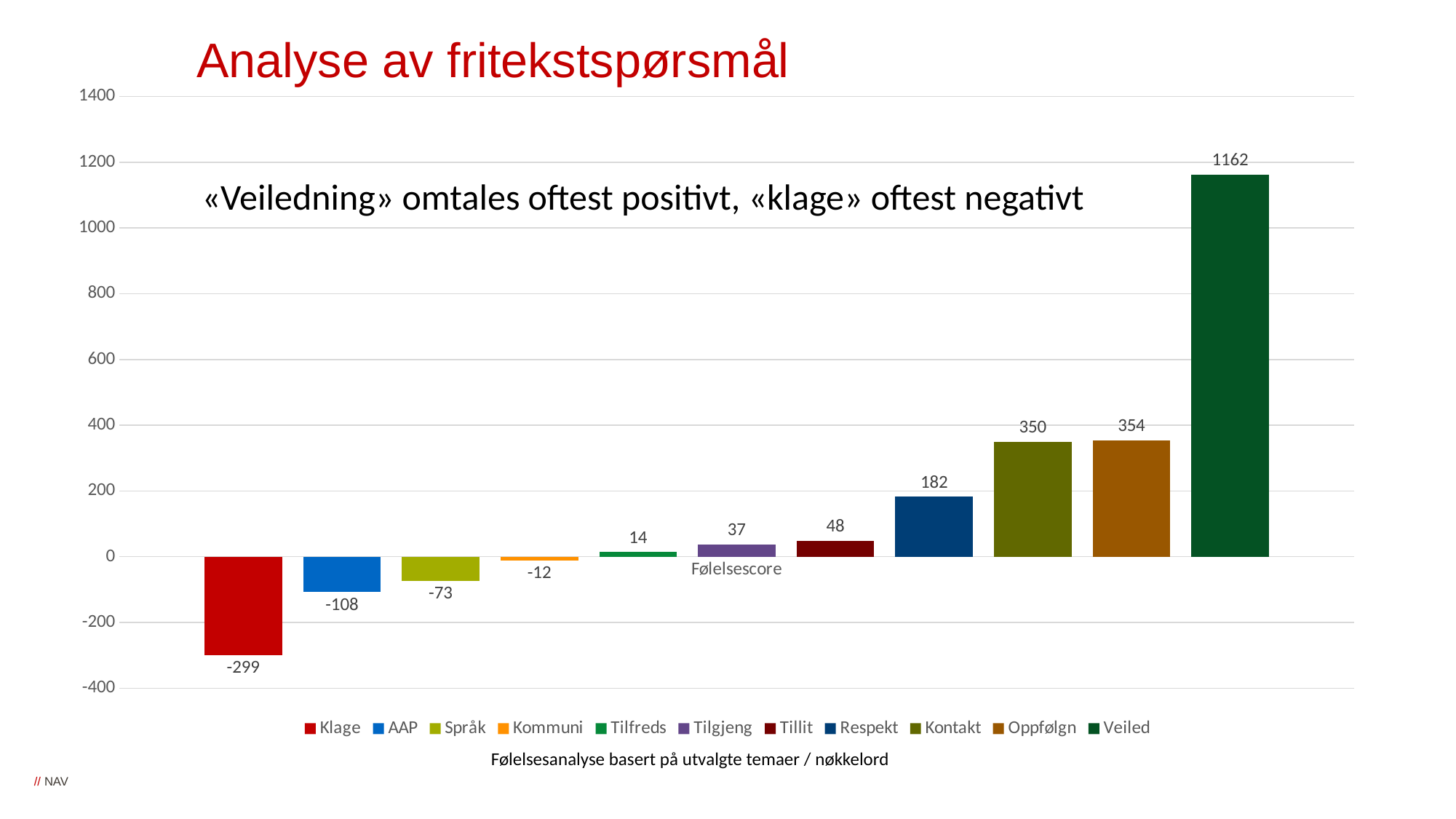
What is the difference between the values for Veiled and Oppfølgn? 808 What is the value for Veiled? 1162 What is the value for Kommuni? -12 Which category has the highest value? Veiled Which category has the lowest value? Klage How many bars are plotted in the chart? 11 What is the value for Respekt? 182 What is the value for Klage? -299 What is the difference between the values for Oppfølgn and Kontakt? 4 What is the title of the chart? Følelsesanalyse basert på utvalgte temaer / nøkkelord Which is larger, the value for Tillit or the value for Tilgjeng? Tillit What kind of chart is shown on the slide? Bar chart